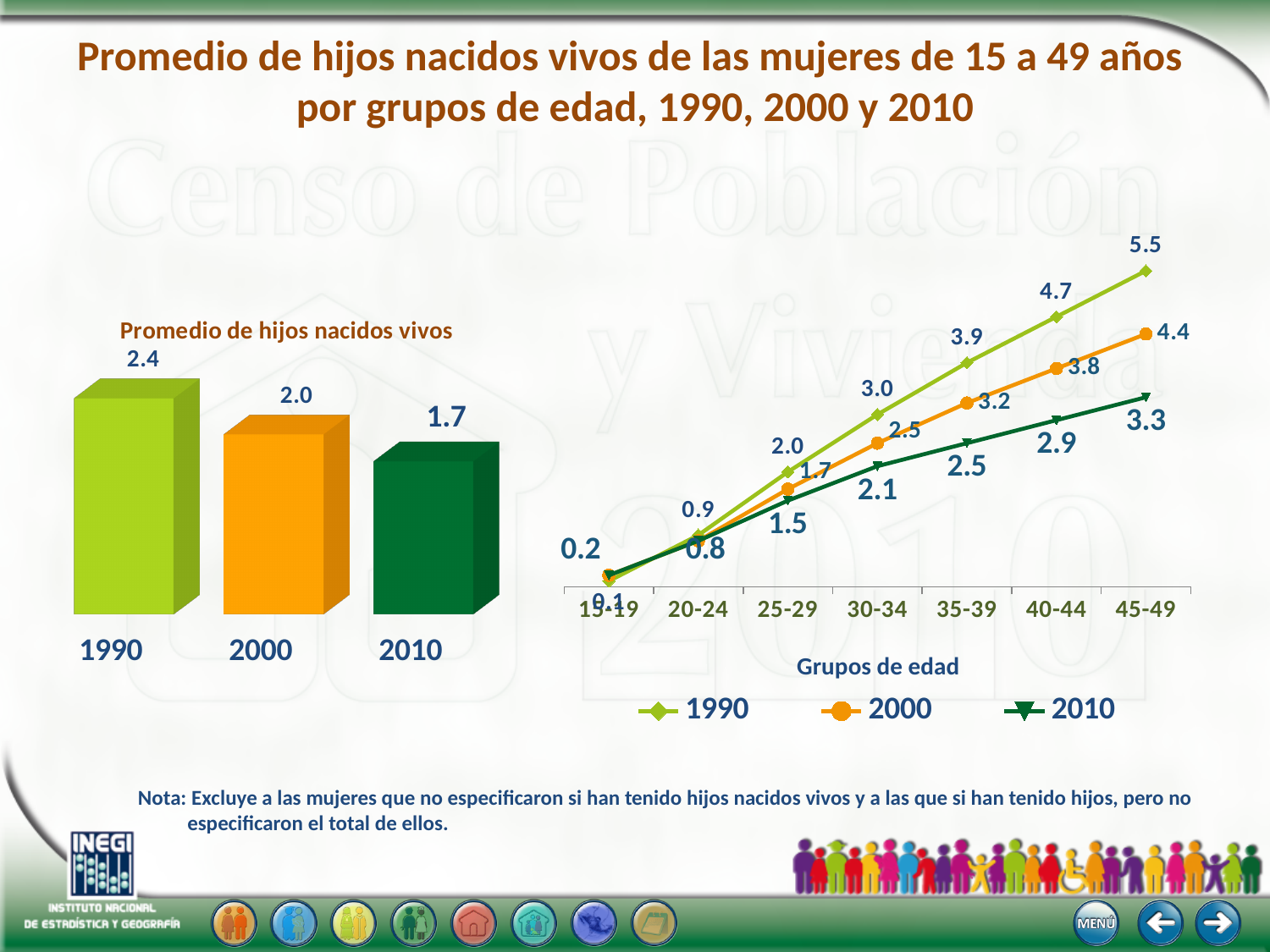
In the bar chart 'Promedio de hijos nacidos vivos', do the values rise or fall from 1990 to 2010? fall In the line chart by 'Grupos de edad', what is the 2000 value for the 35-39 age group? 3.2 In the line chart by 'Grupos de edad', what is the 1990 value for the 45-49 age group? 5.5 In the line chart by 'Grupos de edad', what is the difference between the 1990 and 2000 values for the 45-49 age group? 1.1 In the line chart by 'Grupos de edad', how many series does the legend list? 3 In the line chart by 'Grupos de edad', how many age groups are shown on the x axis? 7 In the bar chart 'Promedio de hijos nacidos vivos', what is the value for 1990? 2.4 In the bar chart 'Promedio de hijos nacidos vivos', what is the difference between the 1990 and 2010 values? 0.7 In the line chart by 'Grupos de edad', which is larger for the 40-44 age group: the 1990 value or the 2010 value? 1990 In the bar chart 'Promedio de hijos nacidos vivos', what is the value for 2010? 1.7 In the line chart by 'Grupos de edad', what is the 2010 value for the 30-34 age group? 2.1 In the bar chart 'Promedio de hijos nacidos vivos', which year has the highest value? 1990